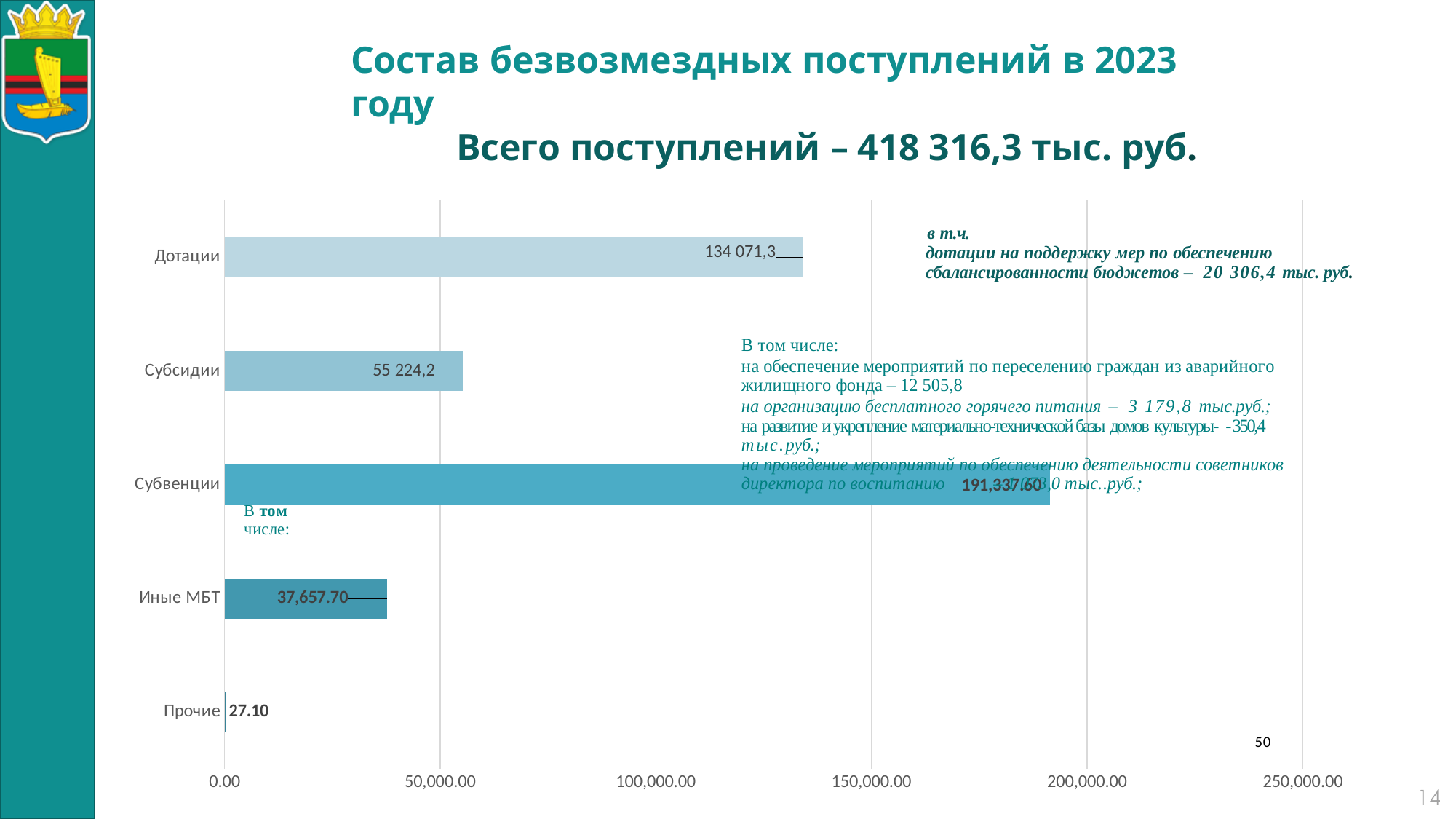
How many categories are shown in the chart? 5 What is the value shown for Прочие? 27.10 What is the value shown for Дотации? 134 071,3 What is the difference between the values for Субвенции and Иные МБТ? 153,679.90 What is the value shown for Субсидии? 55 224,2 Which is larger, the value for Дотации or the value for Субсидии? Дотации Which category has the highest value? Субвенции Which category has the lowest value? Прочие What is the value shown for Иные МБТ? 37,657.70 Is the value for Иные МБТ greater or less than 50,000.00? less What is the value shown for Субвенции? 191,337.60 What kind of chart is shown on the slide? bar chart